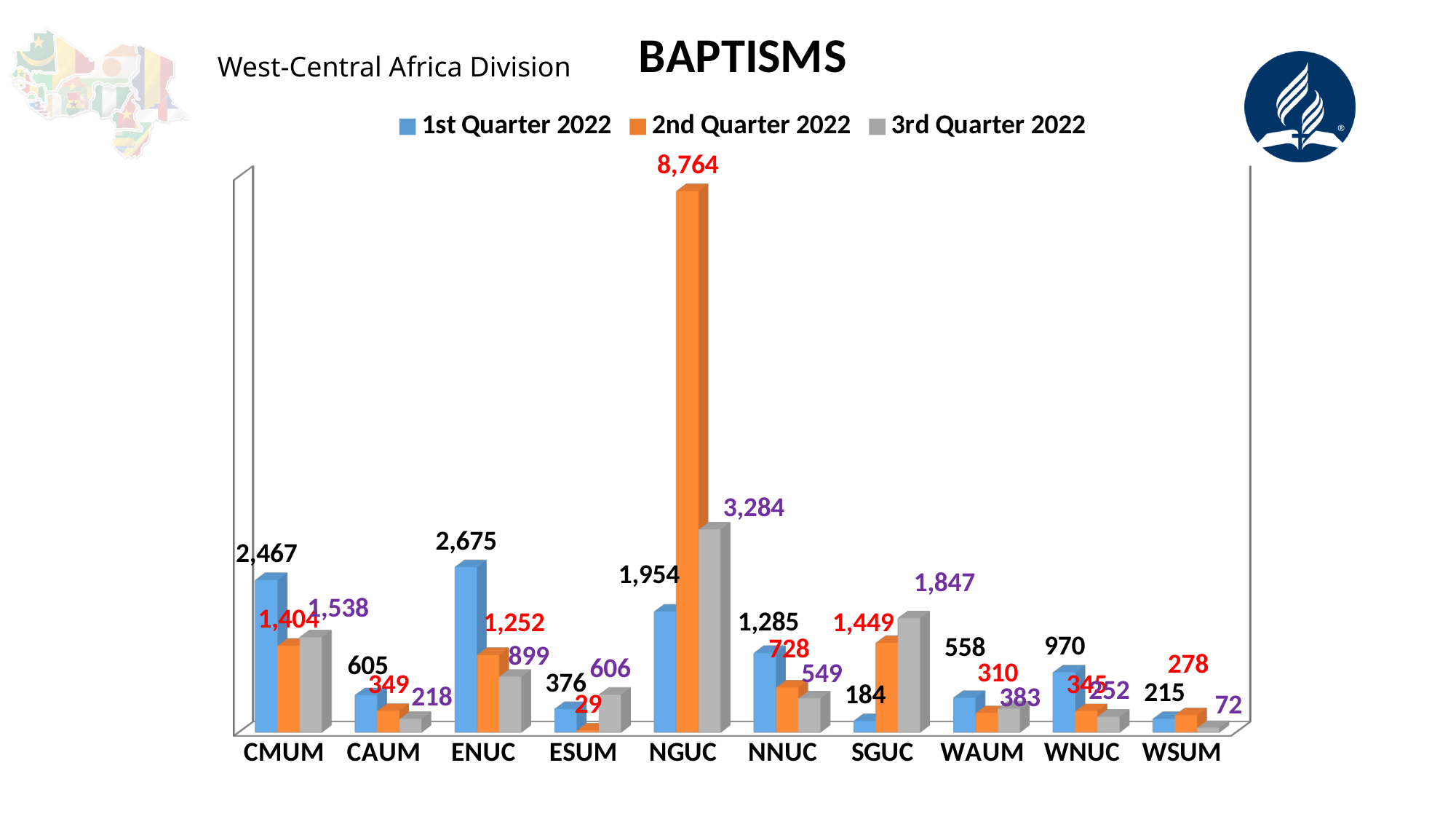
What is the 2nd Quarter 2022 value for NGUC? 8,764 How many categories are shown on the x axis? 10 What is the 2nd Quarter 2022 value for ESUM? 29 What is the 3rd Quarter 2022 value for SGUC? 1,847 Which category has the highest 1st Quarter 2022 value? ENUC What is the difference between the 2nd Quarter 2022 and 3rd Quarter 2022 values for NGUC? 5,480 What is the 1st Quarter 2022 value for ENUC? 2,675 How many series does the legend list? 3 Which is larger for CMUM: the 2nd Quarter 2022 value or the 3rd Quarter 2022 value? 3rd Quarter 2022 Which category has the lowest 3rd Quarter 2022 value? WSUM What is the title of the chart? BAPTISMS What kind of chart is shown on the slide? Bar chart